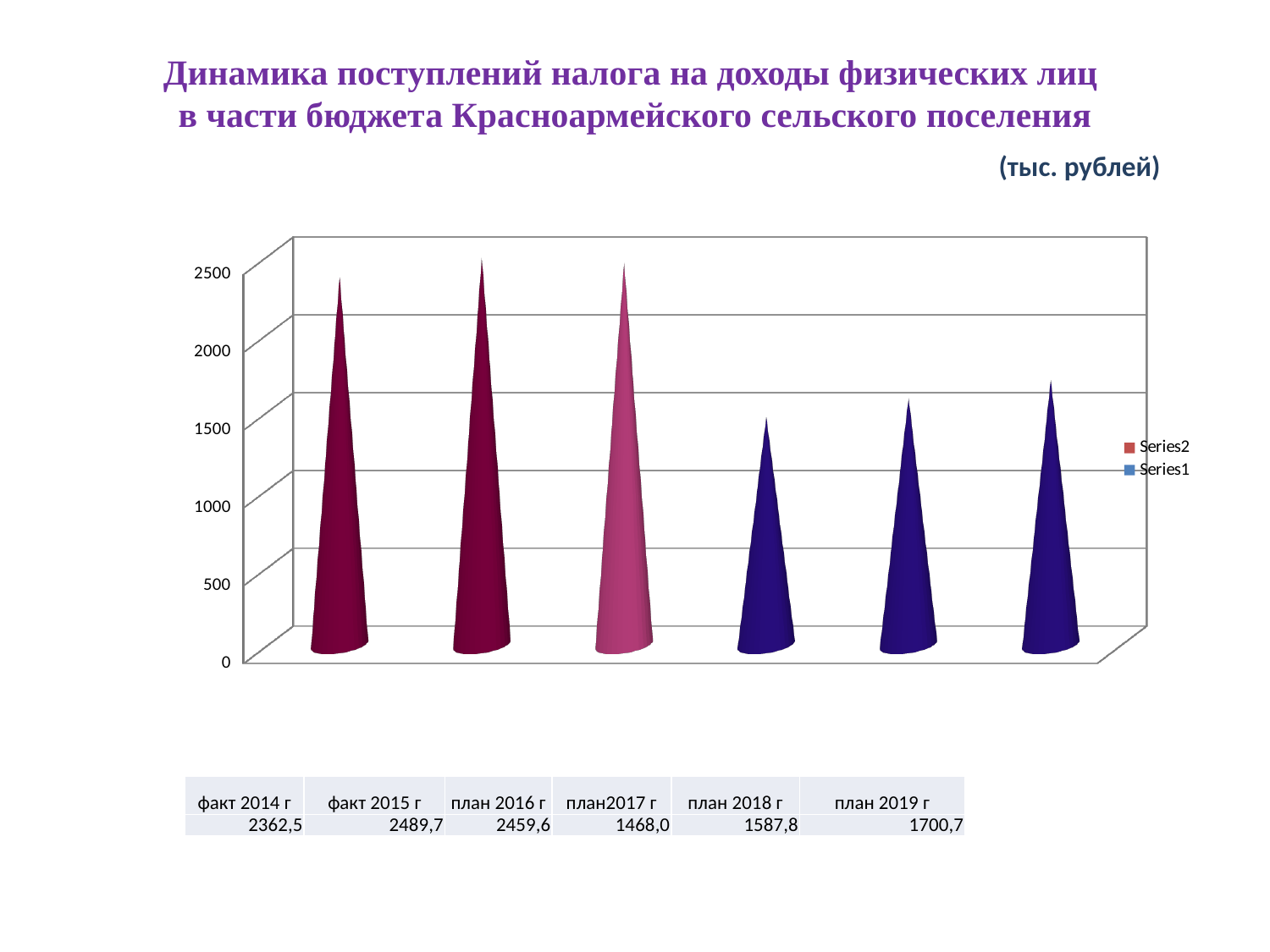
What is the difference between the values for план 2019 г and план2017 г? 232,7 Is the value for план 2018 г greater or less than 1500? greater Do the values rise or fall from план2017 г to план 2019 г? rise What is the value for план 2019 г? 1700,7 What is the value for факт 2014 г? 2362,5 Which is larger, the value for план 2016 г or the value for план 2018 г? план 2016 г How many series does the legend list? 2 What is the difference between the values for факт 2015 г and факт 2014 г? 127,2 Which category has the lowest value? план2017 г Which category has the highest value? факт 2015 г What is the value for план 2018 г? 1587,8 How many categories are shown in the chart? 6